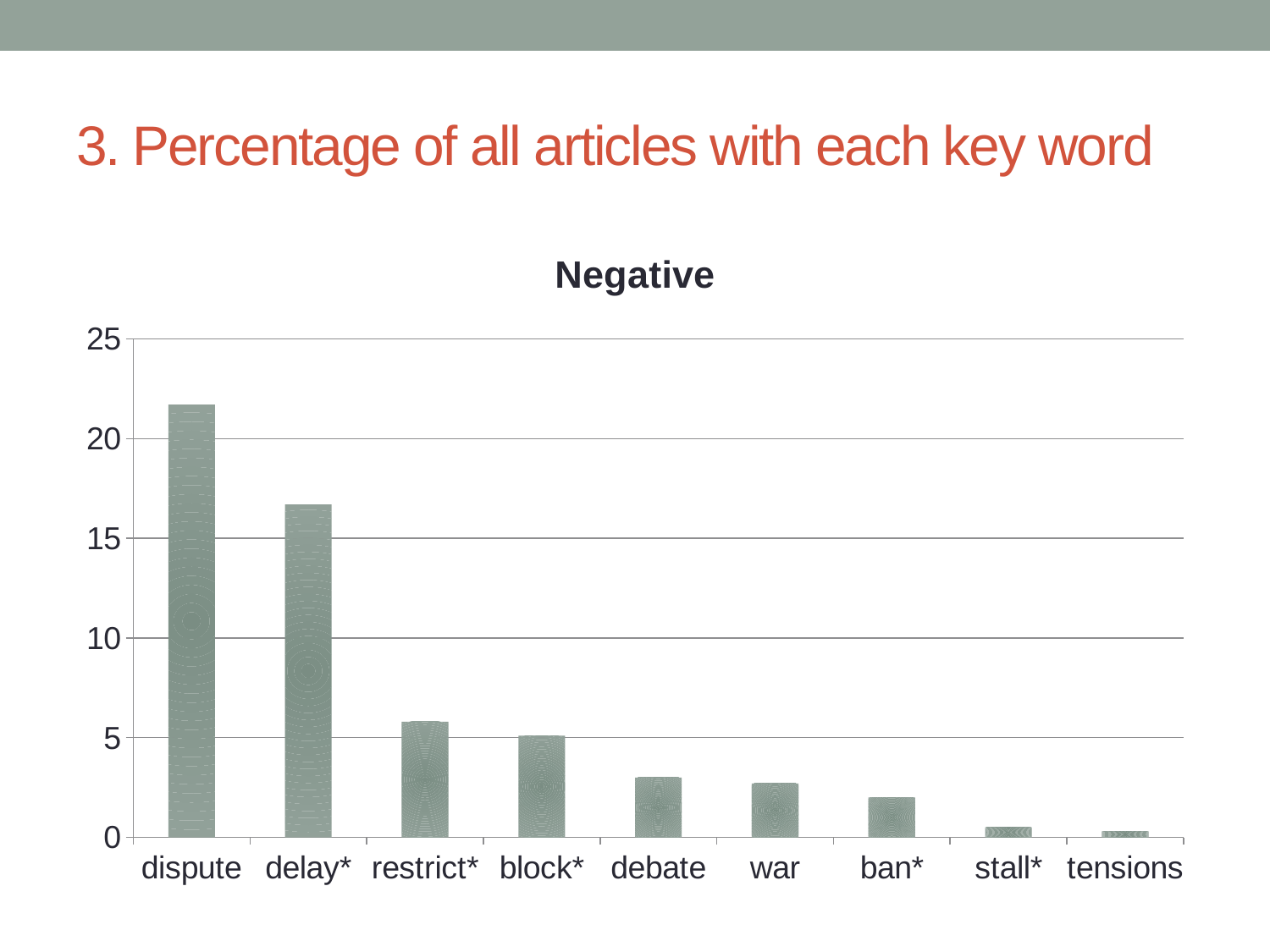
Do the values rise or fall moving from left to right along the x axis? fall Which has a larger value, war or ban*? war Is the value for ban* greater or less than 5? less Is the value for dispute greater or less than 20? greater What kind of chart is shown on the slide? bar chart Which key word has the highest percentage of articles? dispute Is the value for restrict* greater or less than 5? greater What is the title of the chart? Negative How many key words are shown on the x axis? 9 Which has a larger value, dispute or delay*? dispute